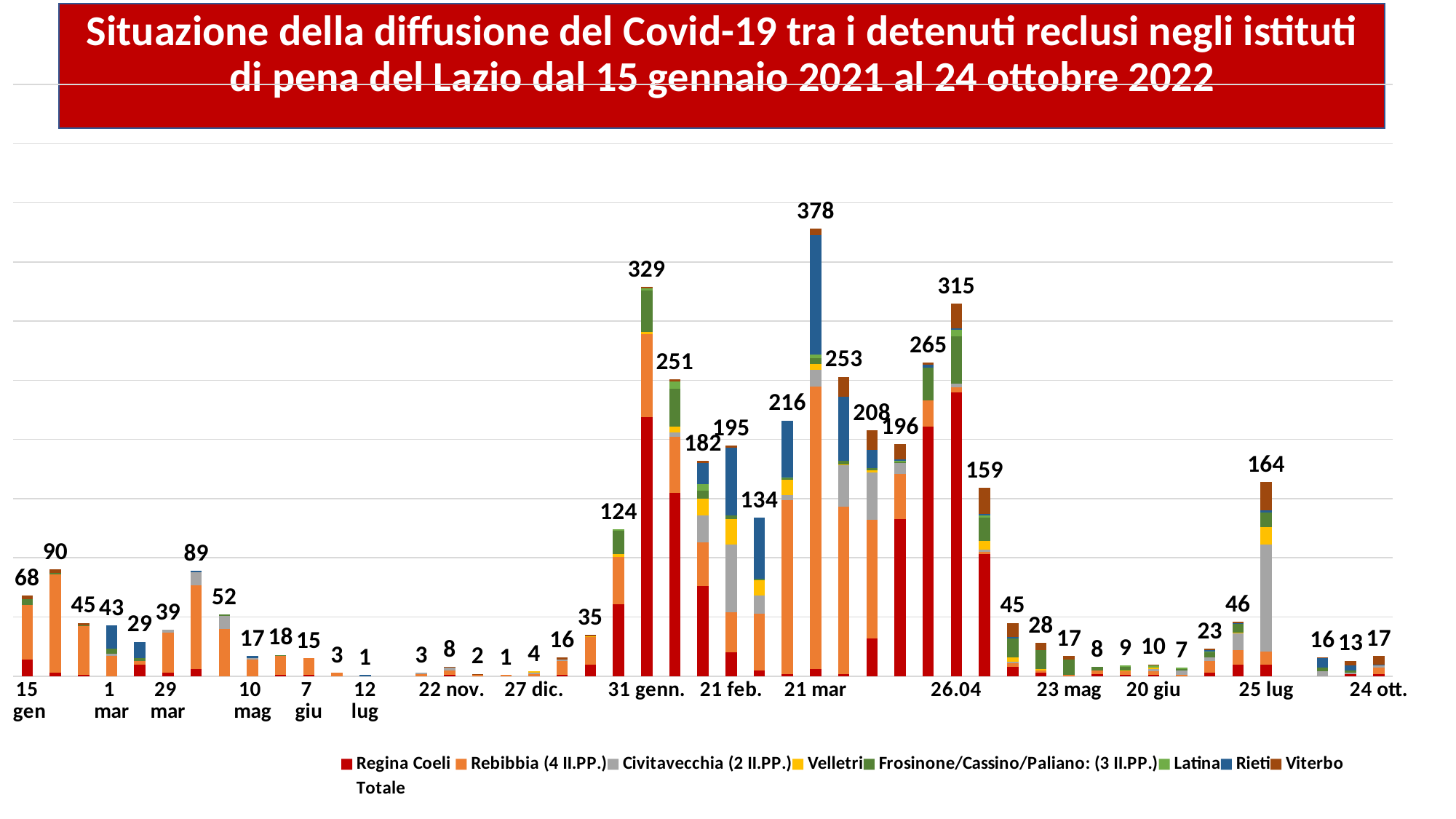
What is the total value shown for the bar labelled 21 mar? 378 What is the total value shown for the last bar, labelled 24 ott.? 17 Which colour represents Regina Coeli in the legend? Red What is the total value shown for the first bar, labelled 15 gen? 68 What is the highest total value labelled on the chart? 378 What is the total value shown for the bar labelled 26.04? 315 Which date has the highest total in the chart? 21 mar What kind of chart is shown on the slide? Stacked bar chart What is the difference between the totals for 21 mar and 31 genn.? 49 What is the total value shown for the bar labelled 31 genn.? 329 What is the total value shown for the bar labelled 25 lug? 164 Which has the larger total, 31 genn. or 26.04? 31 genn.